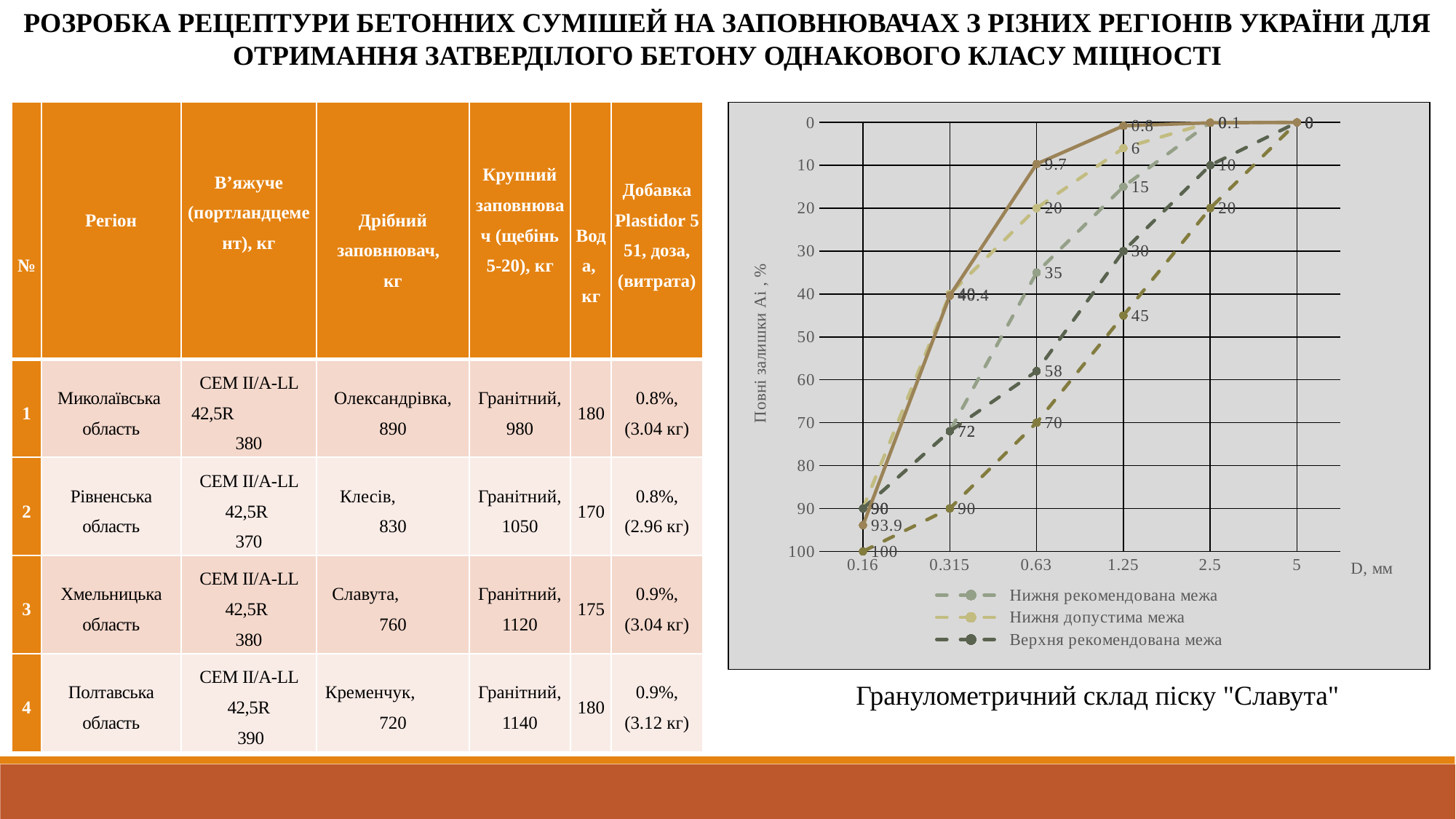
What is the label of the x axis of the chart? D, мм What value does the solid line show at D = 0.63 mm? 9.7 How many series does the chart legend list? 3 Do the plotted values rise or fall as D increases along the x axis? fall What value does the series 'Верхня рекомендована межа' show at D = 0.63 mm? 58 What is the difference between the solid line's values at D = 0.315 mm and D = 0.63 mm? 30.7 How many D values (x-axis ticks) are shown on the chart? 6 What value does the series 'Нижня рекомендована межа' show at D = 0.63 mm? 35 What kind of chart is shown on the slide? line chart What is the caption/title of the chart on the slide? Гранулометричний склад піску "Славута" What value does the solid line show at D = 0.315 mm? 40.4 What value does the solid line show at D = 0.16 mm? 93.9